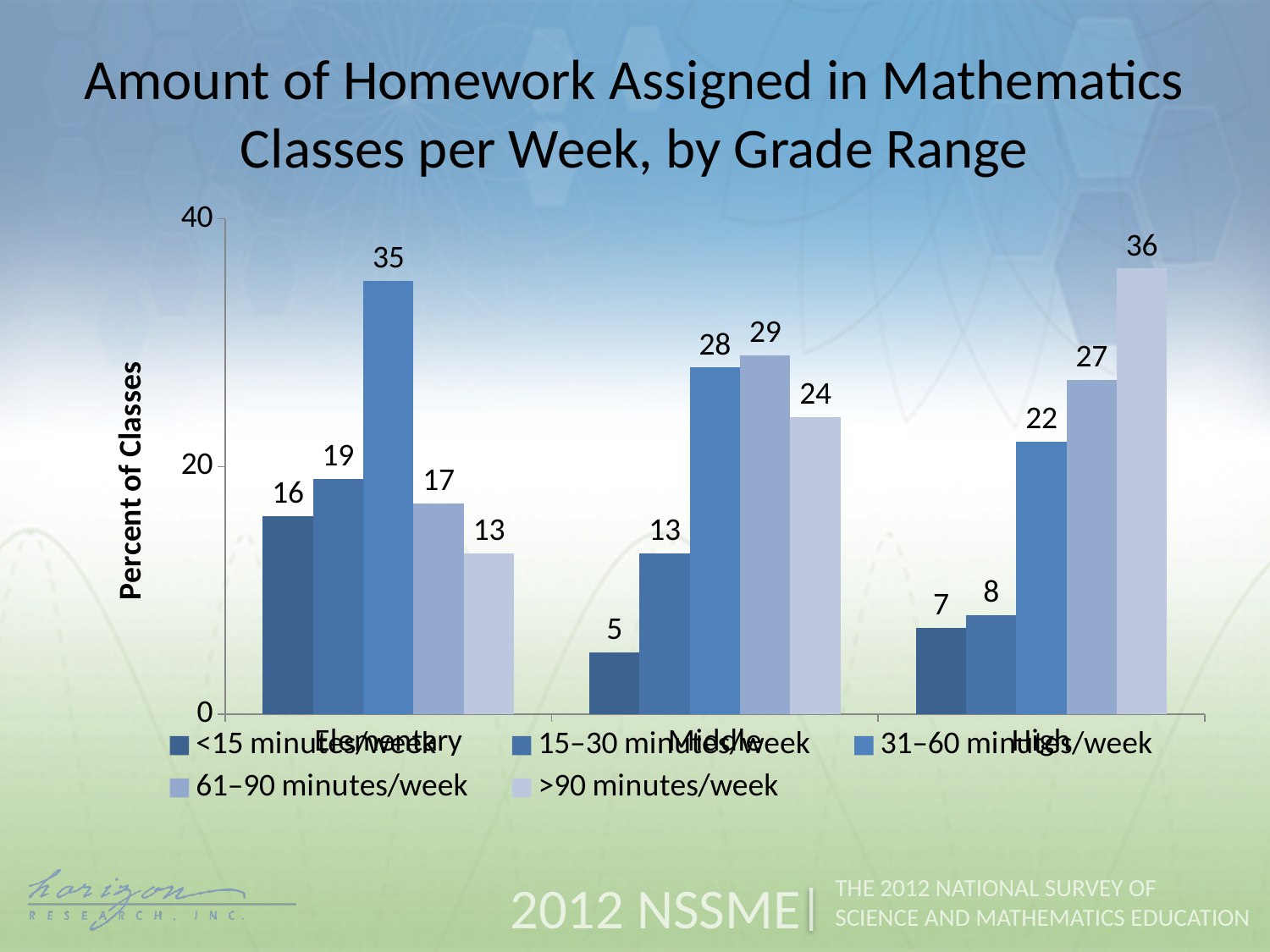
Is the value for 15–30 minutes/week in the Elementary grade range greater or less than 20? less What is the value for <15 minutes/week in the Middle grade range? 5 How many grade ranges are shown on the x axis? 3 Which homework amount has the lowest percent of classes in the High grade range? <15 minutes/week How many series does the legend list? 5 What percent of elementary classes are assigned 31–60 minutes/week of homework? 35 Which homework amount has the highest percent of classes in the Elementary grade range? 31–60 minutes/week What kind of chart is shown on the slide? bar chart What is the value for >90 minutes/week in the High grade range? 36 What is the label of the y axis? Percent of Classes What is the difference between the 61–90 minutes/week values for High and Elementary? 10 Which is larger: the >90 minutes/week value for Middle or for High? High